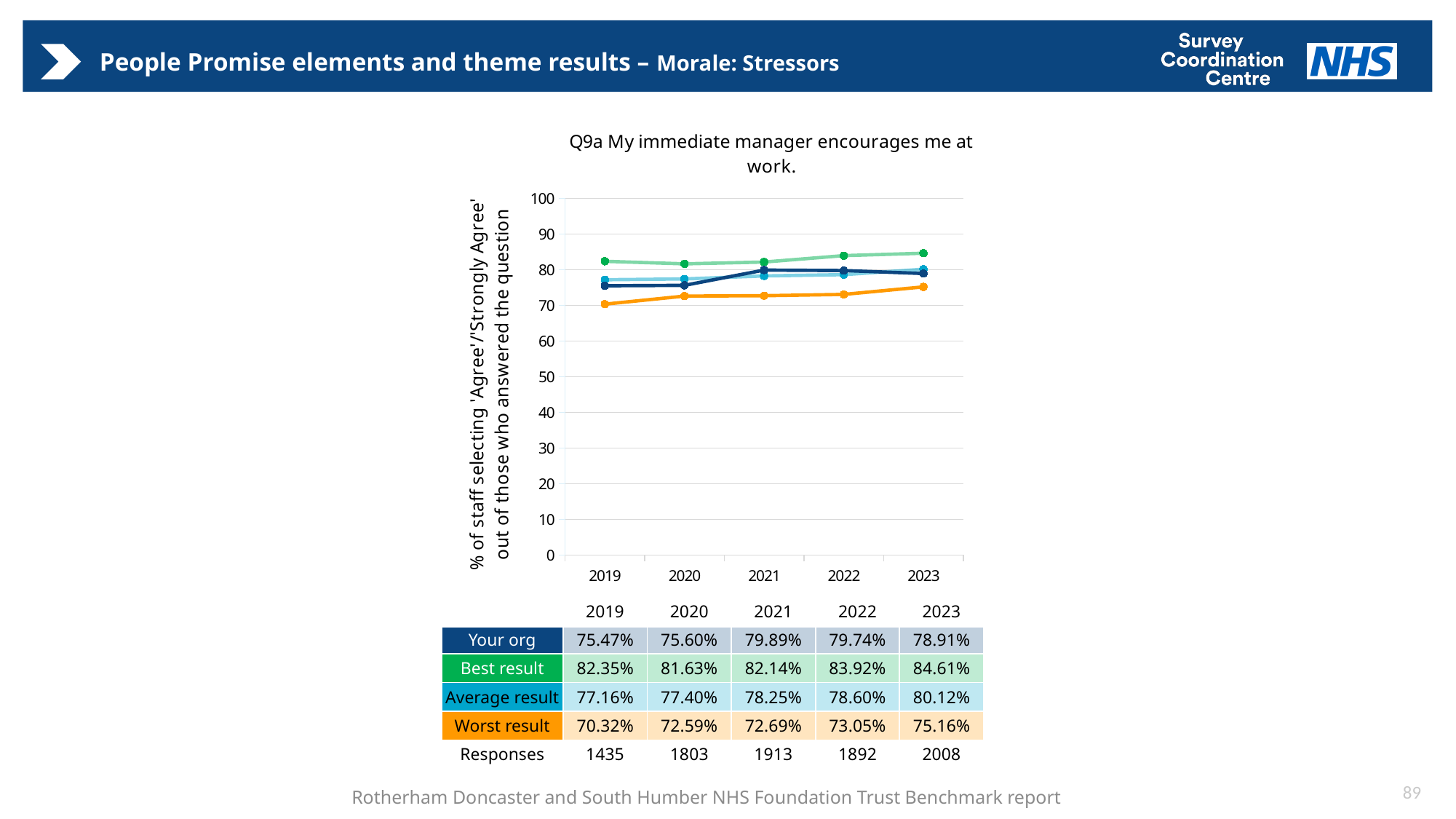
What type of chart is shown on the slide? line chart What is the 'Average result' value for 2022? 78.60% What is the 'Best result' value for 2023? 84.61% In which year is the 'Worst result' value lowest? 2019 Does the 'Average result' line rise or fall from 2019 to 2023? rise What is the difference between the 'Best result' and 'Worst result' values in 2023? 9.45 percentage points How many responses were recorded in 2023? 2008 In which year is the 'Your org' value highest? 2021 How many years are plotted on the x axis? 5 Which is larger in 2020: the 'Your org' value or the 'Average result' value? Average result What is the 'Your org' value for 2021? 79.89% What is the 'Worst result' value for 2019? 70.32%